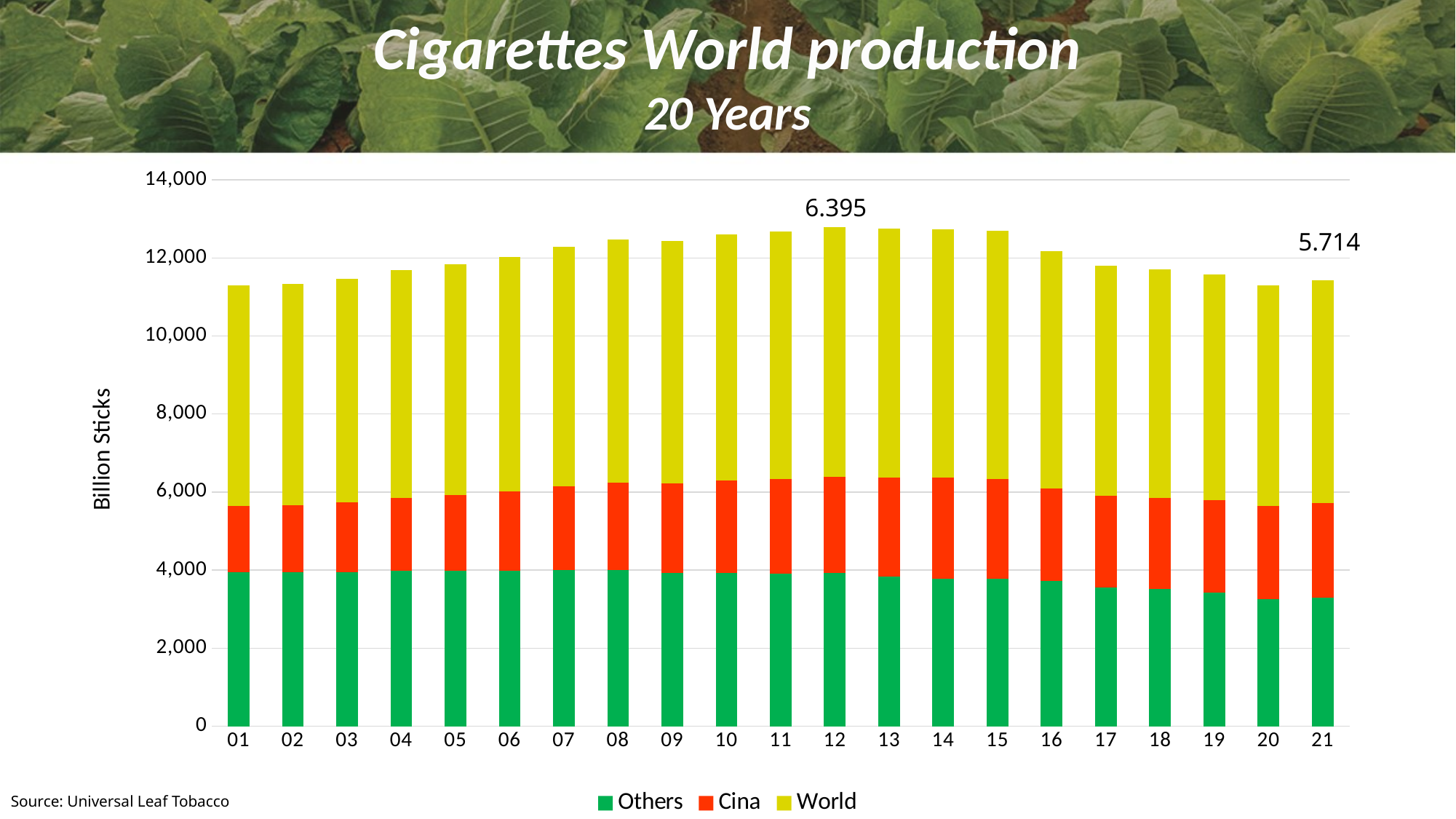
What kind of chart is shown on the slide? Stacked bar chart Is the total height of the stacked bar for year 01 greater or less than 12,000? less Is the Others segment for year 21 greater or less than 4,000? less Is the total height of the stacked bar for year 12 greater or less than 12,000? greater What is the label on the vertical axis? Billion Sticks How many series does the legend list? 3 How many years (categories) are shown on the x axis? 21 Which stacked bar is taller in total, year 12 or year 01? Year 12 Do the total stacked bar heights rise or fall from year 15 to year 21? Fall Which series is shown in yellow in the legend? World What value is printed above the bar for year 12? 6.395 What value is printed above the bar for year 21? 5.714